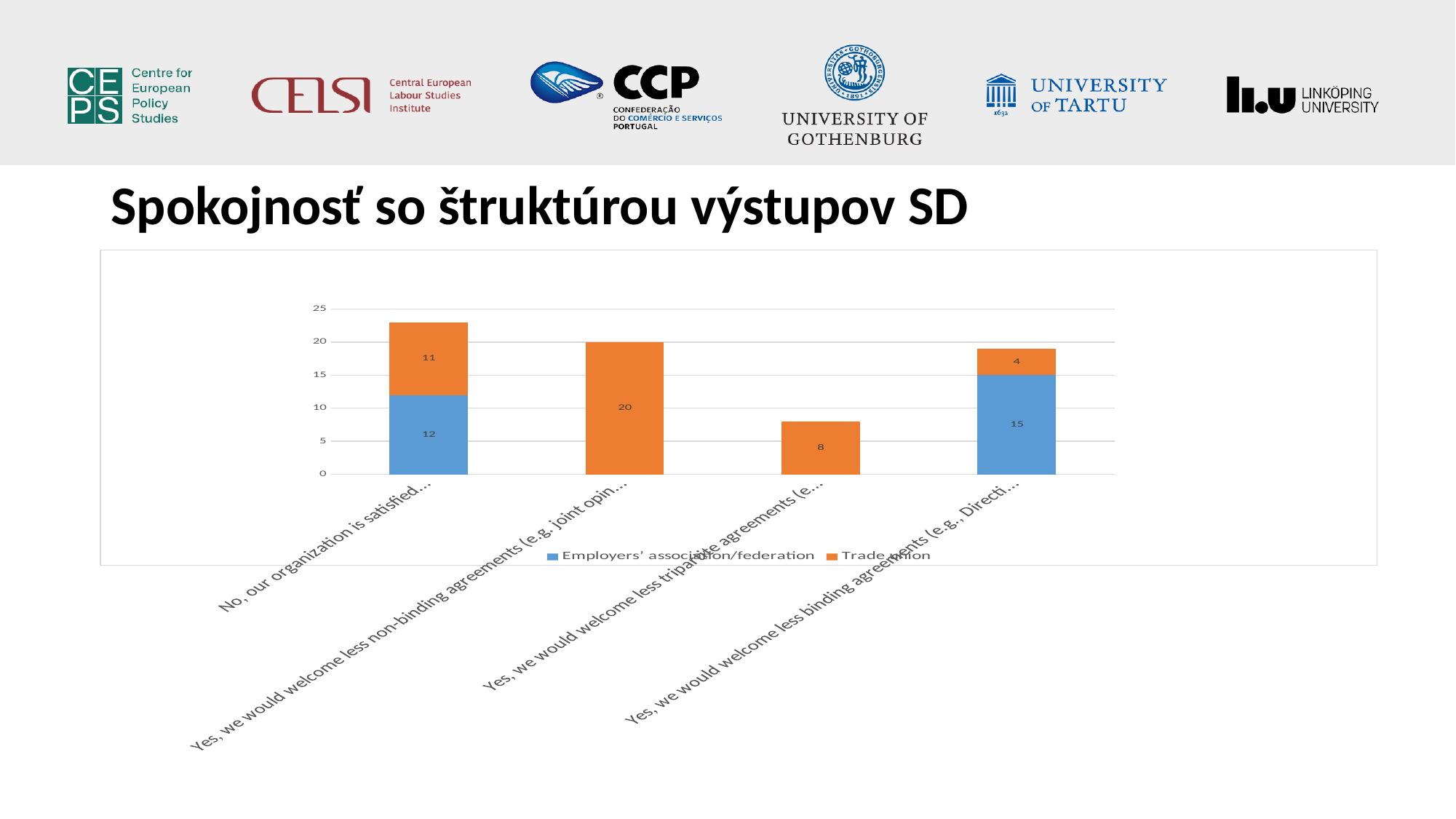
What kind of chart is shown on the slide? stacked bar chart What is the Employers' association/federation value for the category 'Yes, we would welcome less binding agreements…'? 15 What is the difference between the Employers' association/federation value and the Trade union value for 'Yes, we would welcome less binding agreements…'? 11 How many categories are shown on the x axis? 4 What is the Employers' association/federation value for the category 'No, our organization is satisfied…'? 12 What is the total of the stacked bar for 'No, our organization is satisfied…'? 23 What is the Trade union value for the category 'Yes, we would welcome less tripartite agreements…'? 8 What is the Trade union value for the category 'No, our organization is satisfied…'? 11 Which category has the highest Trade union value? Yes, we would welcome less non-binding agreements… How many series does the legend list? 2 What is the Trade union value for the category 'Yes, we would welcome less non-binding agreements…'? 20 What is the total of the stacked bar for 'Yes, we would welcome less binding agreements…'? 19